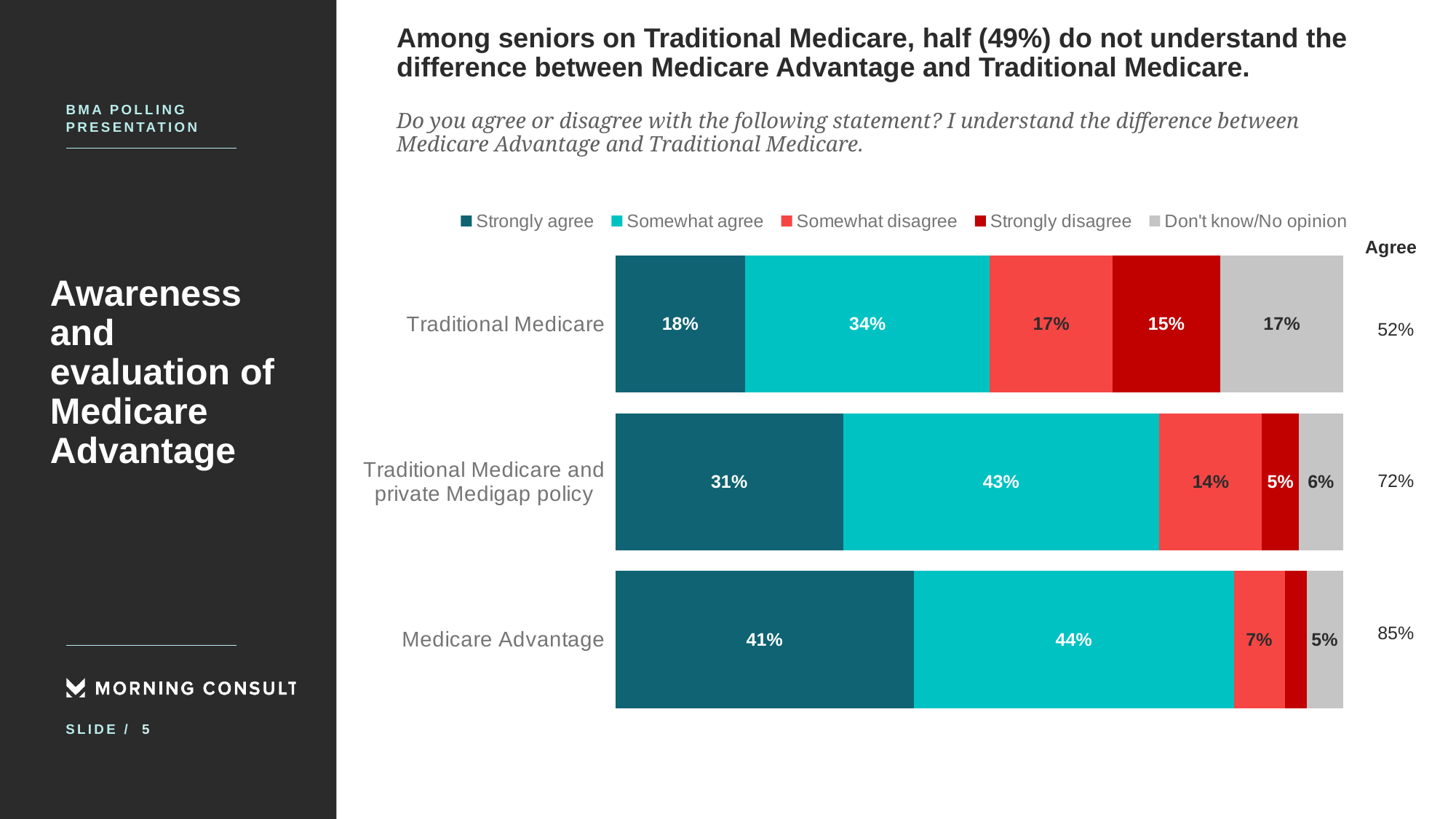
What is the Don't know/No opinion value for Traditional Medicare? 17% What percentage of Medicare Advantage respondents somewhat agree? 44% Which category has the lowest Somewhat agree value? Traditional Medicare What kind of chart is shown on the slide? Stacked bar chart Which category has the highest Strongly agree value? Medicare Advantage What percentage of Traditional Medicare respondents strongly agree? 18% What is the Somewhat disagree value for Traditional Medicare and private Medigap policy? 14% How many series does the legend list? 5 Which is larger: the Strongly disagree value for Traditional Medicare or for Traditional Medicare and private Medigap policy? Traditional Medicare How many categories are shown on the chart? 3 What is the difference between the Strongly agree values for Medicare Advantage and Traditional Medicare? 23 percentage points What is the combined Agree value shown for Traditional Medicare and private Medigap policy? 72%